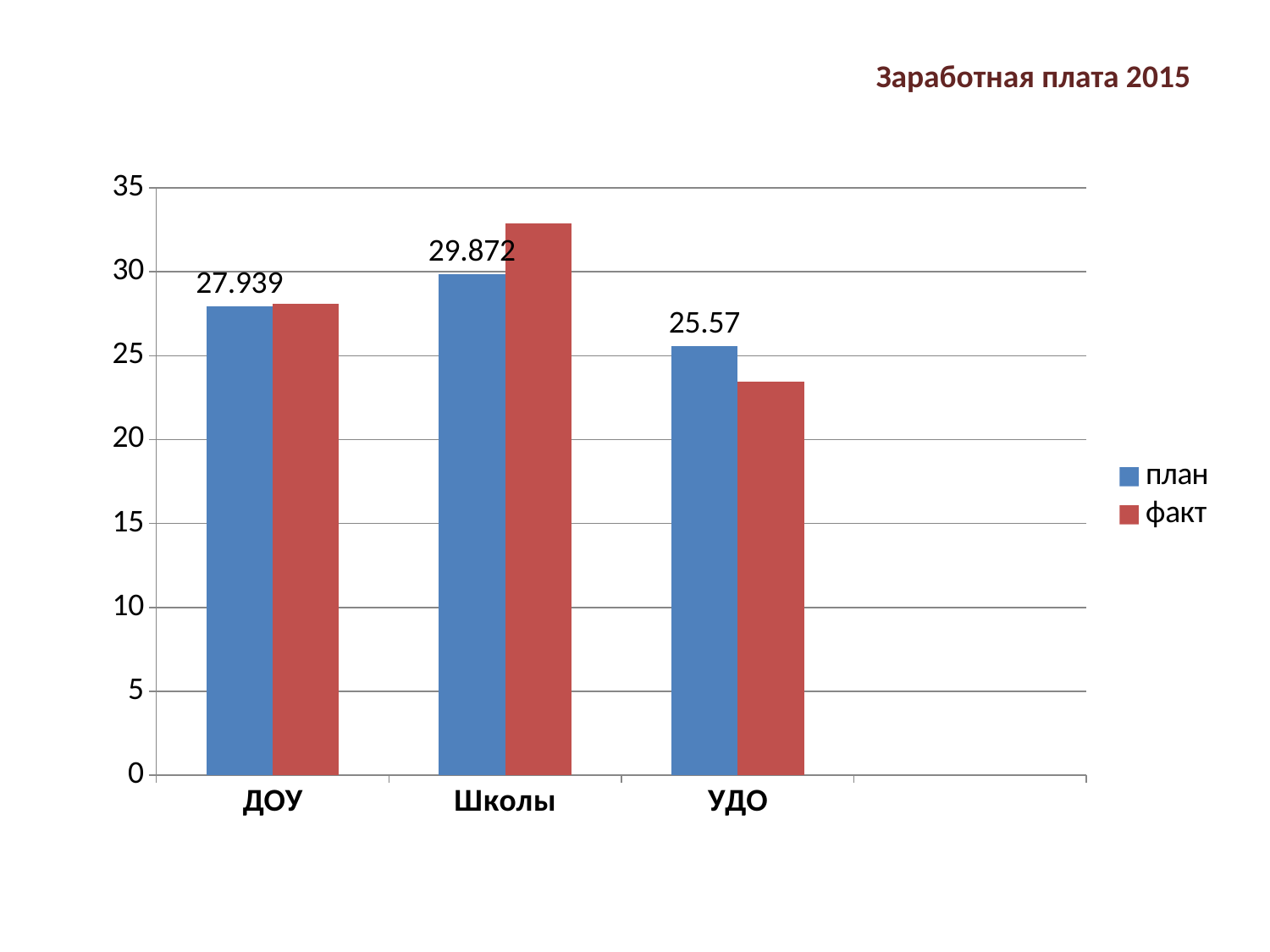
How many series does the legend list? 2 What is the title of the chart? Заработная плата 2015 What is the difference between the план values for Школы and ДОУ? 1.933 How many categories are shown on the x axis? 3 Is the факт value for УДО greater or less than 25? less For УДО, which is larger: план or факт? план Which category has the highest план value? Школы What is the план value for Школы? 29.872 What is the план value for УДО? 25.57 Which category has the lowest план value? УДО What is the план value for ДОУ? 27.939 Is the факт value for Школы greater or less than 30? greater